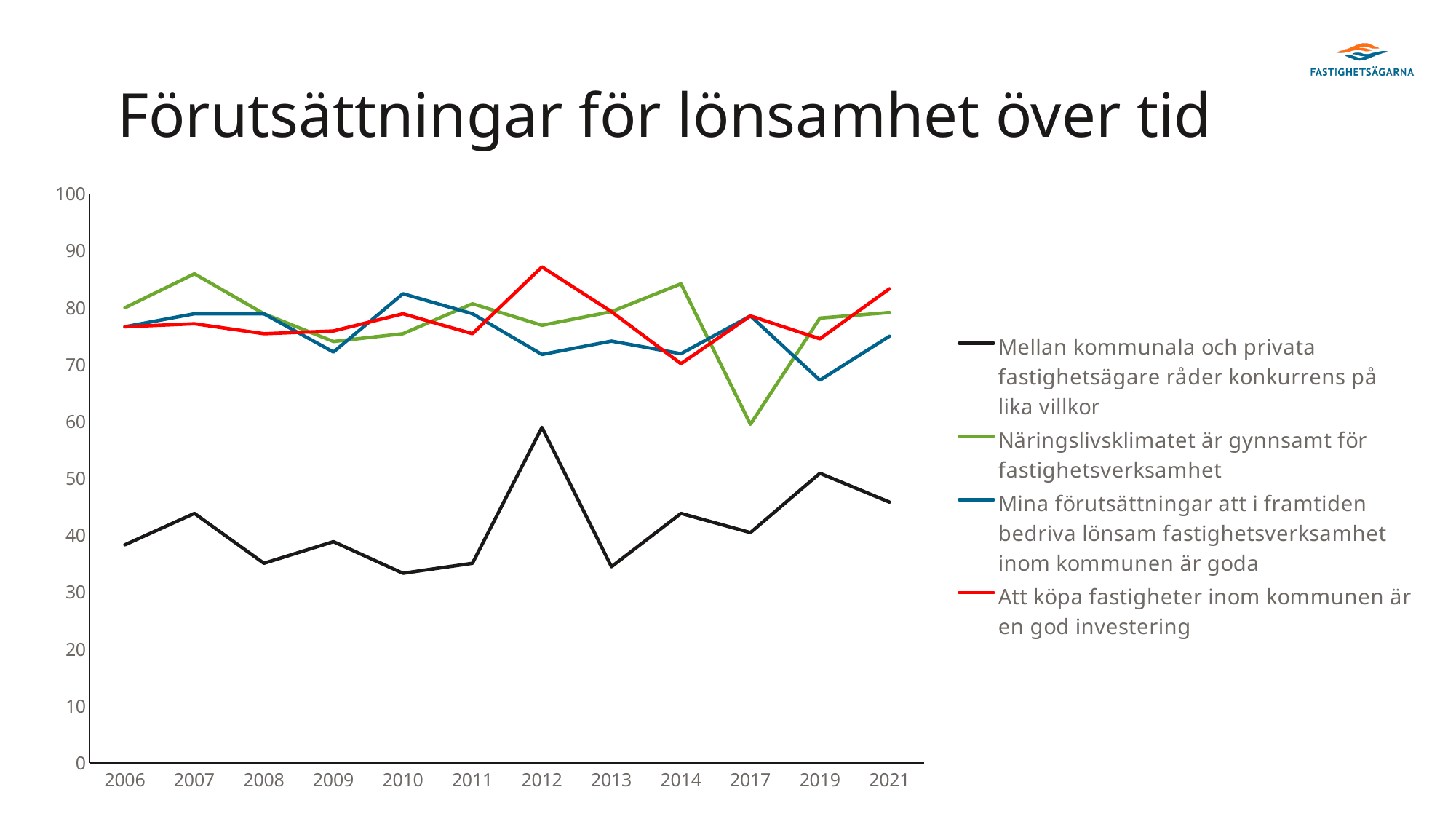
Which colour is used for the series 'Att köpa fastigheter inom kommunen är en god investering'? red How many years are shown on the x axis? 12 How many series does the legend list? 4 Is the 2017 value for 'Näringslivsklimatet är gynnsamt för fastighetsverksamhet' greater or less than 70? less In which year does the series 'Mellan kommunala och privata fastighetsägare råder konkurrens på lika villkor' reach its highest value? 2012 In which year does the series 'Näringslivsklimatet är gynnsamt för fastighetsverksamhet' reach its lowest value? 2017 What kind of chart is shown on the slide? line chart In which year does the series 'Mina förutsättningar att i framtiden bedriva lönsam fastighetsverksamhet inom kommunen är goda' reach its lowest value? 2019 Does the series 'Mellan kommunala och privata fastighetsägare råder konkurrens på lika villkor' rise or fall from 2010 to 2012? rise Is the 2012 value for 'Mellan kommunala och privata fastighetsägare råder konkurrens på lika villkor' greater or less than 50? greater What is the title of the slide? Förutsättningar för lönsamhet över tid In 2012, which series has the higher value: 'Att köpa fastigheter inom kommunen är en god investering' or 'Mina förutsättningar att i framtiden bedriva lönsam fastighetsverksamhet inom kommunen är goda'? Att köpa fastigheter inom kommunen är en god investering